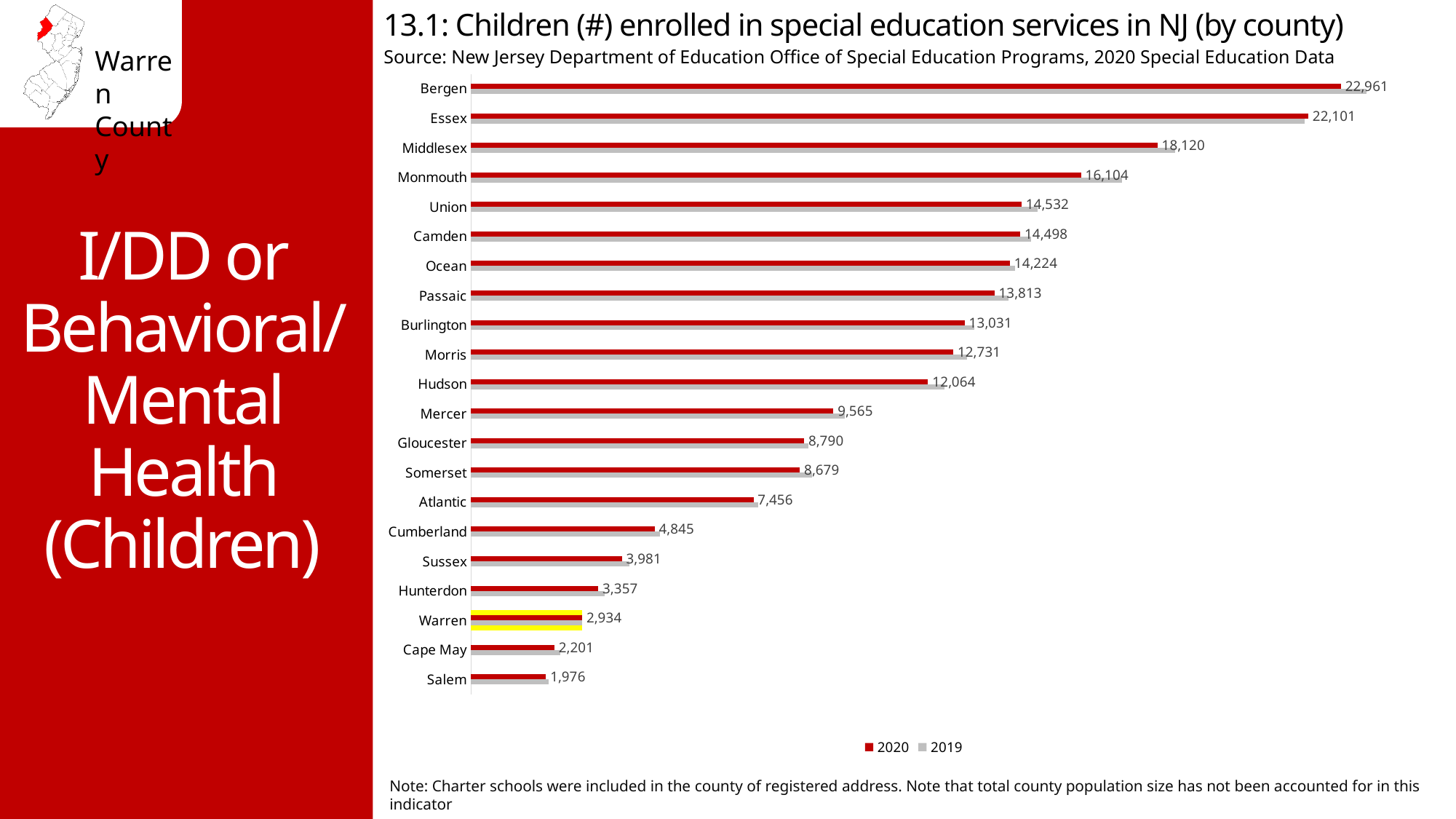
How many series does the legend list? 2 Which county has a larger 2020 value, Hunterdon or Sussex? Sussex What is the 2020 value for Salem County? 1,976 How many counties are shown in the chart? 21 What is the difference between the 2020 values for Warren and Cape May? 733 Which year is represented by the red bars in the chart? 2020 What is the 2020 value for Bergen County? 22,961 What is the difference between the 2020 values for Bergen and Essex? 860 What is the 2020 value for Warren County? 2,934 Which county has the highest number of children enrolled in special education services in 2020? Bergen Which county has the lowest number of children enrolled in special education services in 2020? Salem What kind of chart is shown on the slide? Bar chart